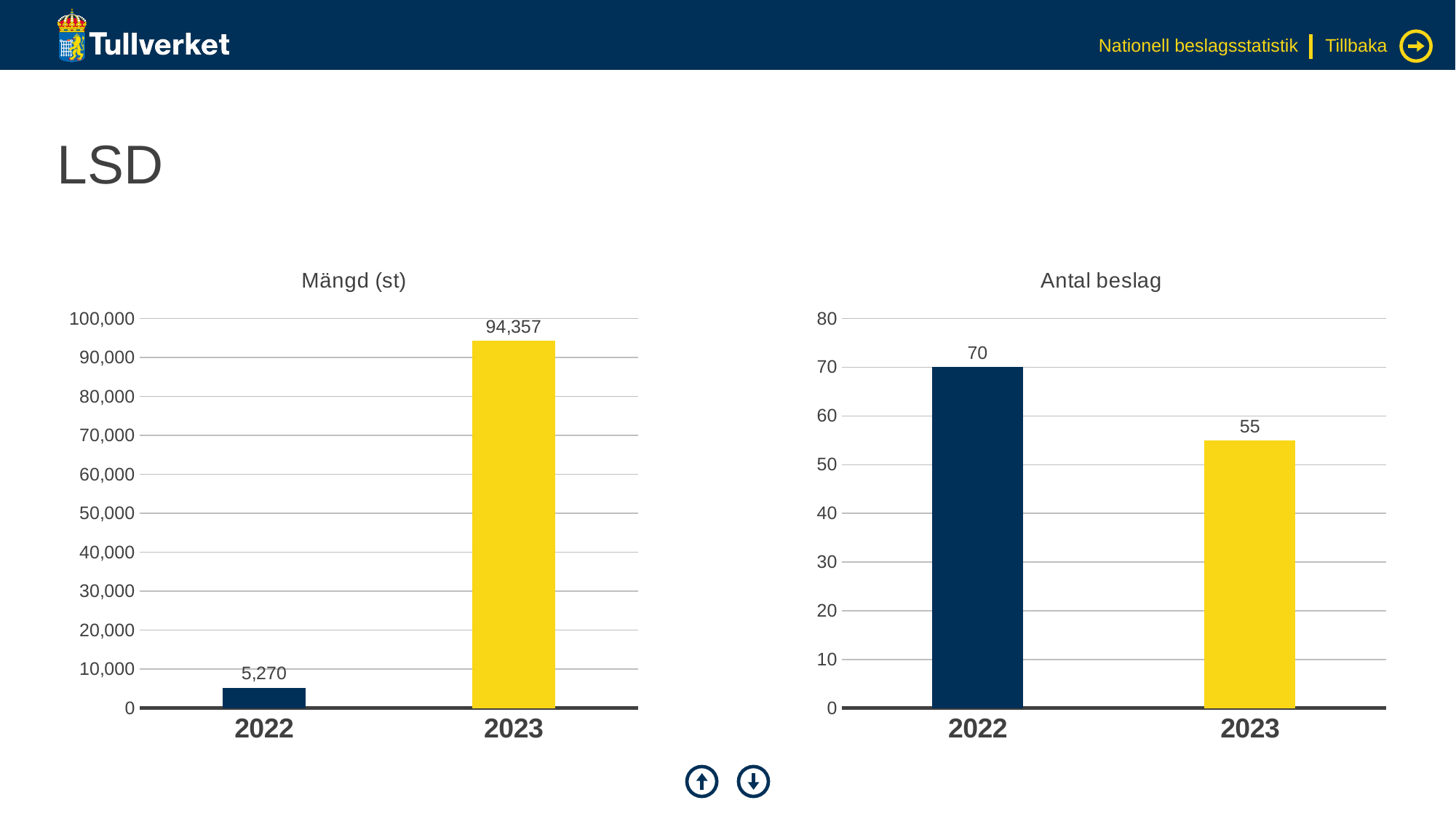
In the "Antal beslag" chart, what is the value for 2022? 70 In the "Antal beslag" chart, which year has the lowest value? 2023 In the "Antal beslag" chart, what is the difference between the 2022 and 2023 values? 15 In the "Antal beslag" chart, what is the value for 2023? 55 In the "Mängd (st)" chart, what is the difference between the 2023 and 2022 values? 89,087 In the "Mängd (st)" chart, is the value for 2022 greater or less than 10,000? less How many bars are shown in the "Antal beslag" chart? 2 In the "Mängd (st)" chart, which year has the highest value? 2023 What type of chart is the "Mängd (st)" chart? bar chart In the "Mängd (st)" chart, what is the value for 2022? 5,270 In the "Antal beslag" chart, is the value for 2022 larger or smaller than the value for 2023? larger In the "Mängd (st)" chart, what is the value for 2023? 94,357